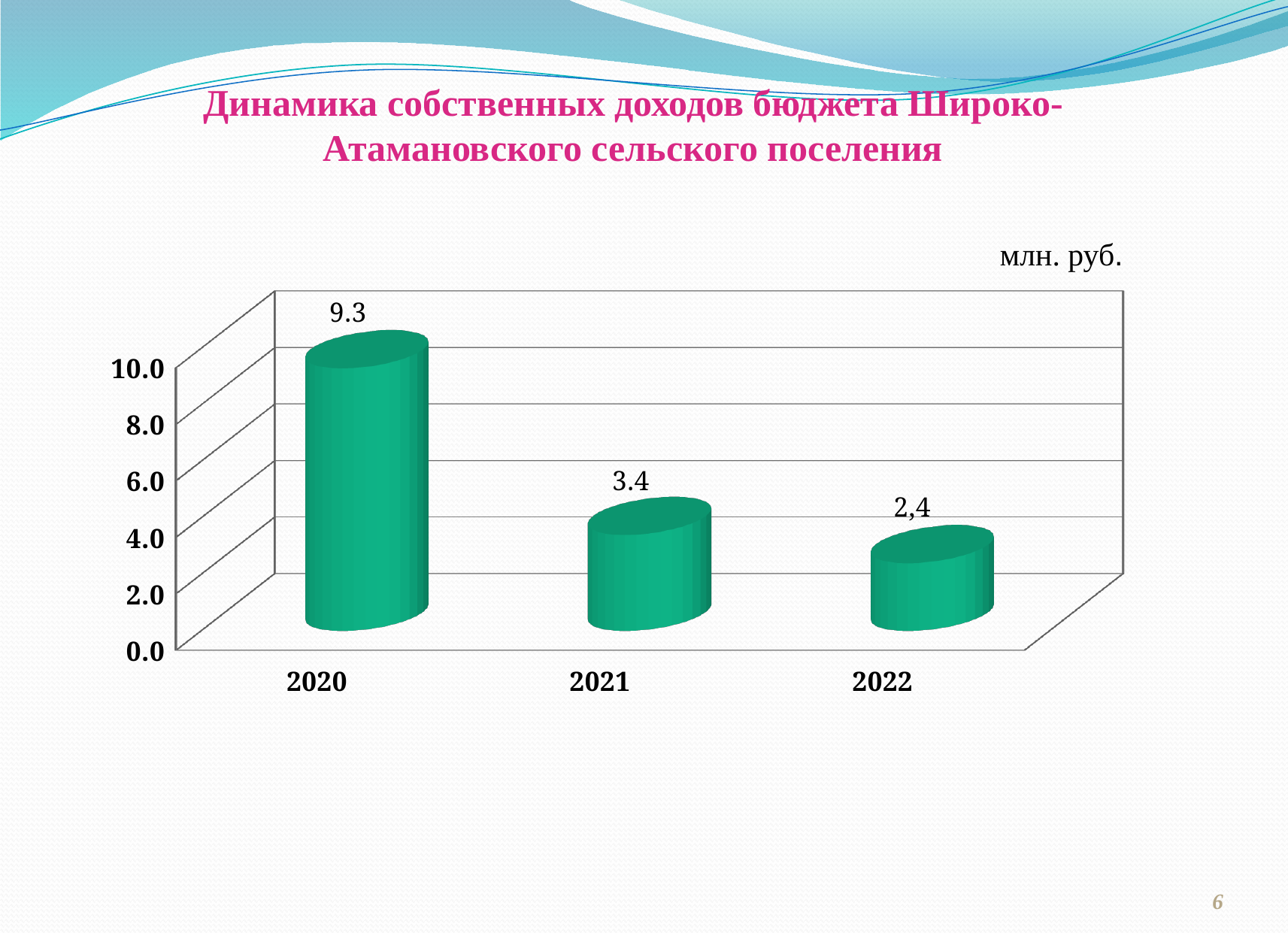
Which year has the lowest value? 2022 What is the value for 2020? 9.3 What is the difference between the values for 2021 and 2022? 1.0 What is the value for 2021? 3.4 What is the value for 2022? 2,4 How many years are shown on the x axis? 3 Which is larger, the value for 2021 or the value for 2022? 2021 What kind of chart is shown on the slide? Bar chart Is the value for 2020 greater or less than 8.0? greater Do the values rise or fall from 2020 to 2022? Fall What is the difference between the values for 2020 and 2021? 5.9 Which year has the highest value? 2020